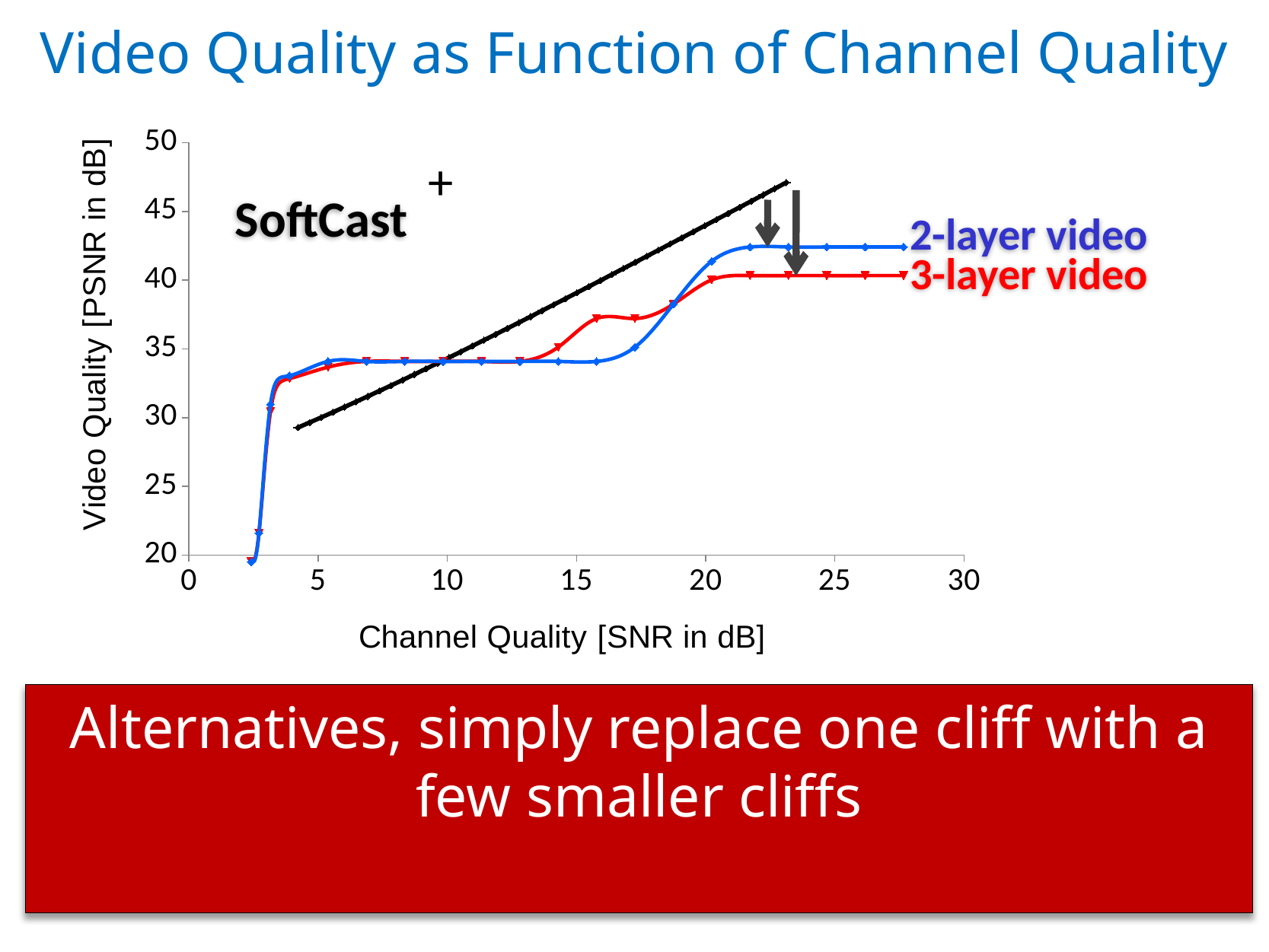
What kind of chart is shown on the slide? line chart What is the title of the chart on the slide? Video Quality as Function of Channel Quality At an SNR of 16 dB, which line is higher: 2-layer video or 3-layer video? 3-layer video At an SNR of 25 dB, which line is higher: 2-layer video or 3-layer video? 2-layer video Is the value of the 3-layer video line at an SNR of 17 dB greater or less than 35? greater What is the label of the x axis? Channel Quality [SNR in dB] Is the value of the 2-layer video line at an SNR of 25 dB greater or less than 40? greater How many data series are plotted on the chart? 3 Is the value of the SoftCast line at an SNR of 5 dB greater or less than 35? less Which series reaches the highest video quality at an SNR of 23 dB? SoftCast Does the SoftCast line rise or fall as channel quality increases? rise